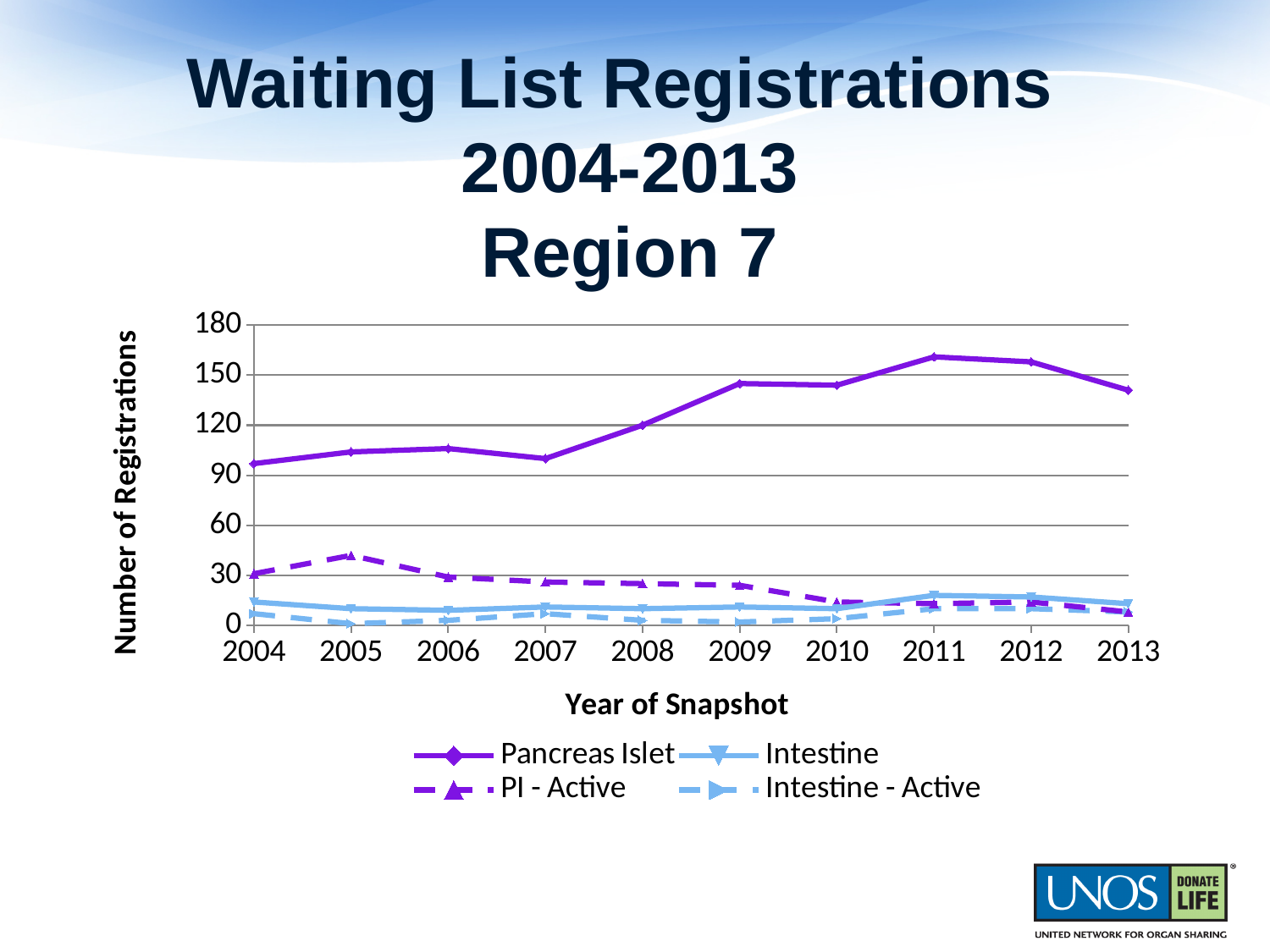
Does the Pancreas Islet series rise or fall between 2007 and 2011? rise Is the value for Pancreas Islet in 2011 greater or less than 150? greater Is the value for Pancreas Islet in 2007 greater or less than 120? less Is the value for Pancreas Islet in 2004 greater or less than 90? greater How many years are plotted along the x axis? 10 How many series does the legend list? 4 What kind of chart is shown on the slide? line chart What is the title of the x axis? Year of Snapshot In which year is the PI - Active series at its highest? 2005 In 2010, which series has the larger value, Pancreas Islet or Intestine? Pancreas Islet